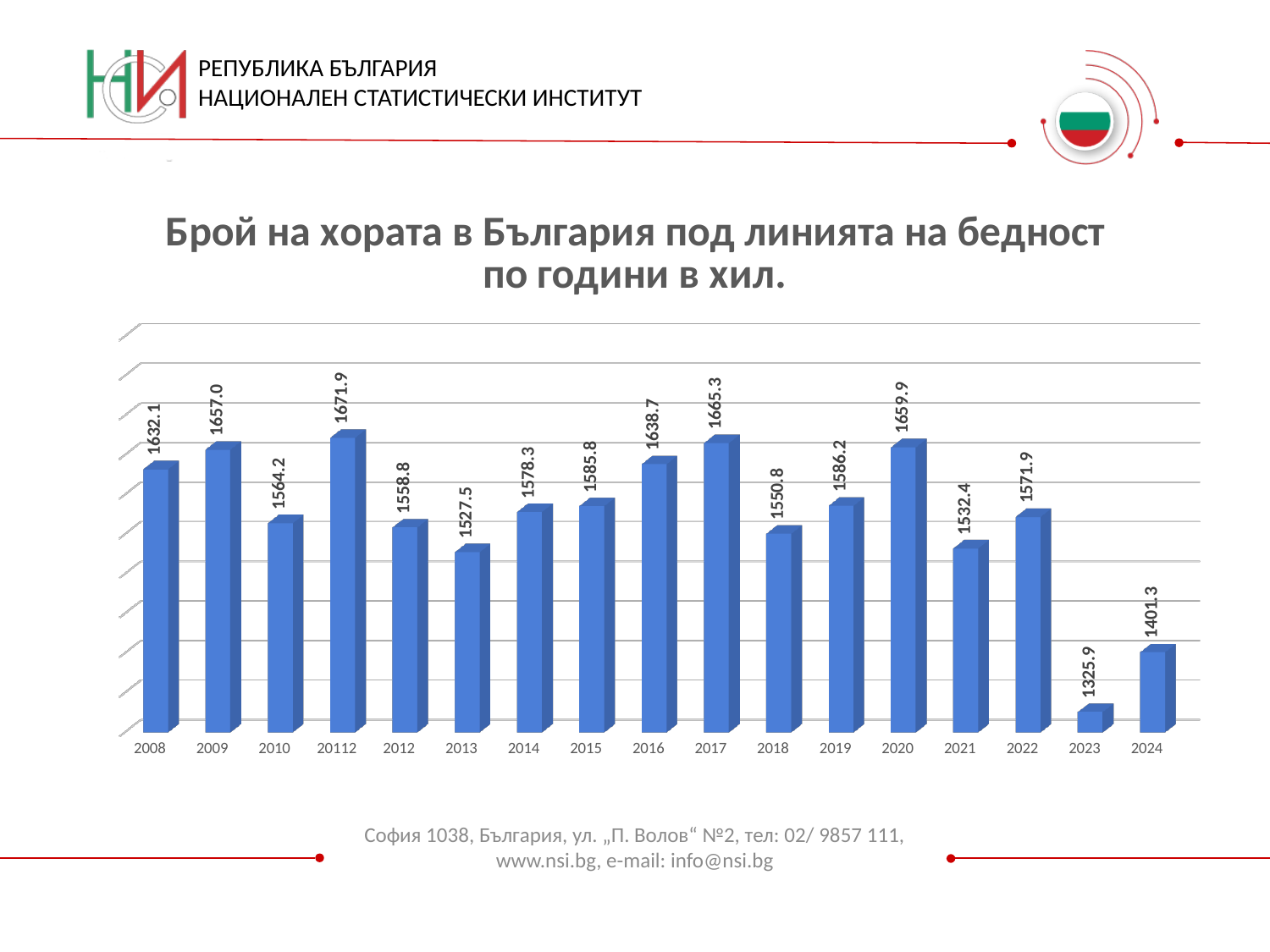
What is the value for 2008? 1632.1 What is the value for 2017? 1665.3 What is the value for 2023? 1325.9 What is the difference between the values for 2024 and 2023? 75.4 What kind of chart is this? bar chart What is the value for 2024? 1401.3 What is the difference between the values for 2017 and 2018? 114.5 Which year has the lowest value? 2023 What is the highest value shown on the chart? 1671.9 Do the values rise or fall from 2020 to 2023? fall Which is larger, the value for 2016 or the value for 2017? 2017 How many years are shown on the x axis? 17